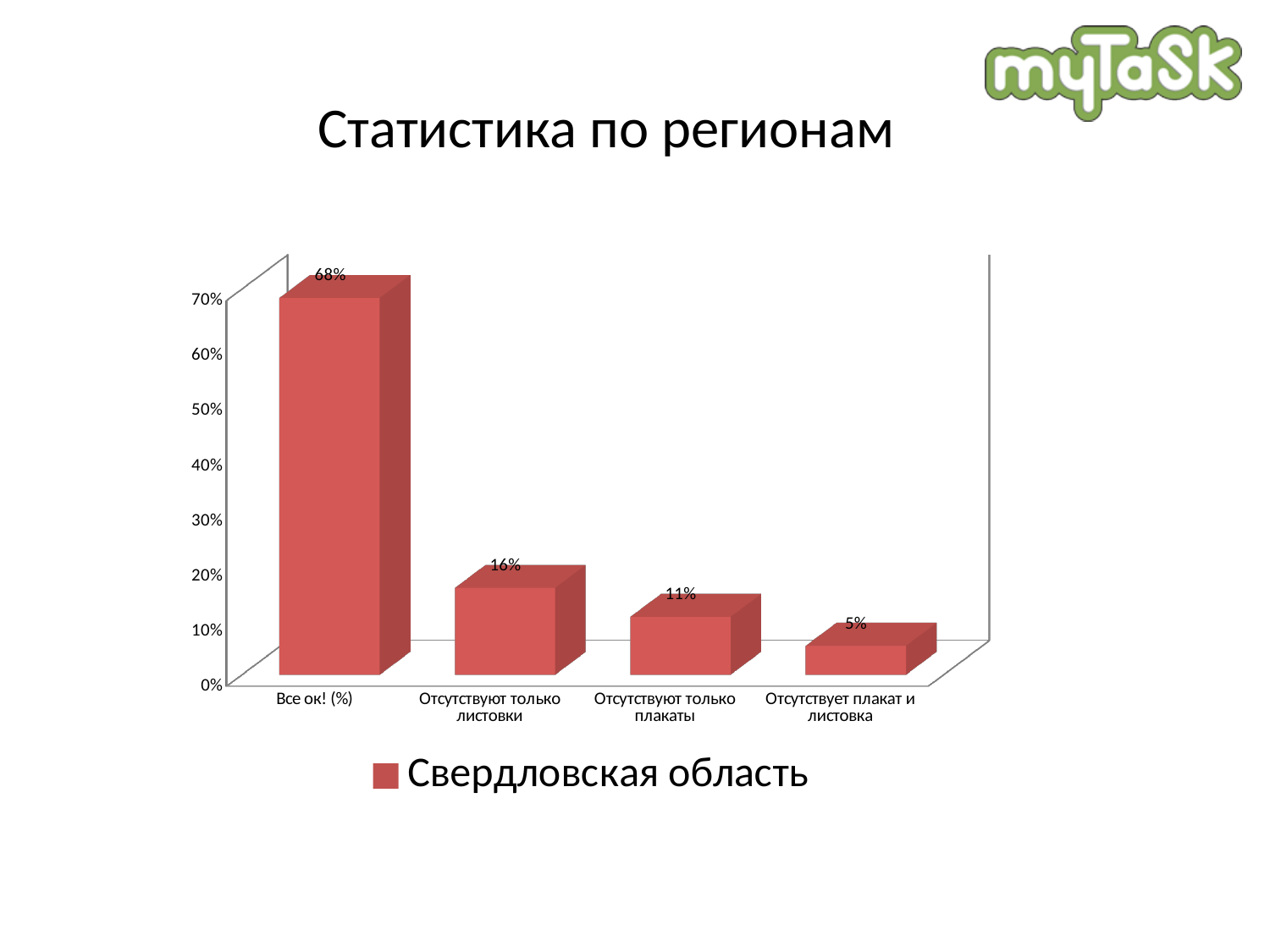
How many categories are shown on the x axis? 4 What series name is shown in the legend? Свердловская область What is the difference between the values for "Все ок! (%)" and "Отсутствуют только листовки"? 52% Which category has the highest value? Все ок! (%) What is the value for "Отсутствуют только листовки"? 16% What is the value for "Все ок! (%)"? 68% What kind of chart is shown on the slide? Bar chart Which is larger: the value for "Отсутствуют только листовки" or "Отсутствуют только плакаты"? Отсутствуют только листовки Which category has the lowest value? Отсутствует плакат и листовка How many series does the legend list? 1 What is the value for "Отсутствуют только плакаты"? 11% What is the value for "Отсутствует плакат и листовка"? 5%